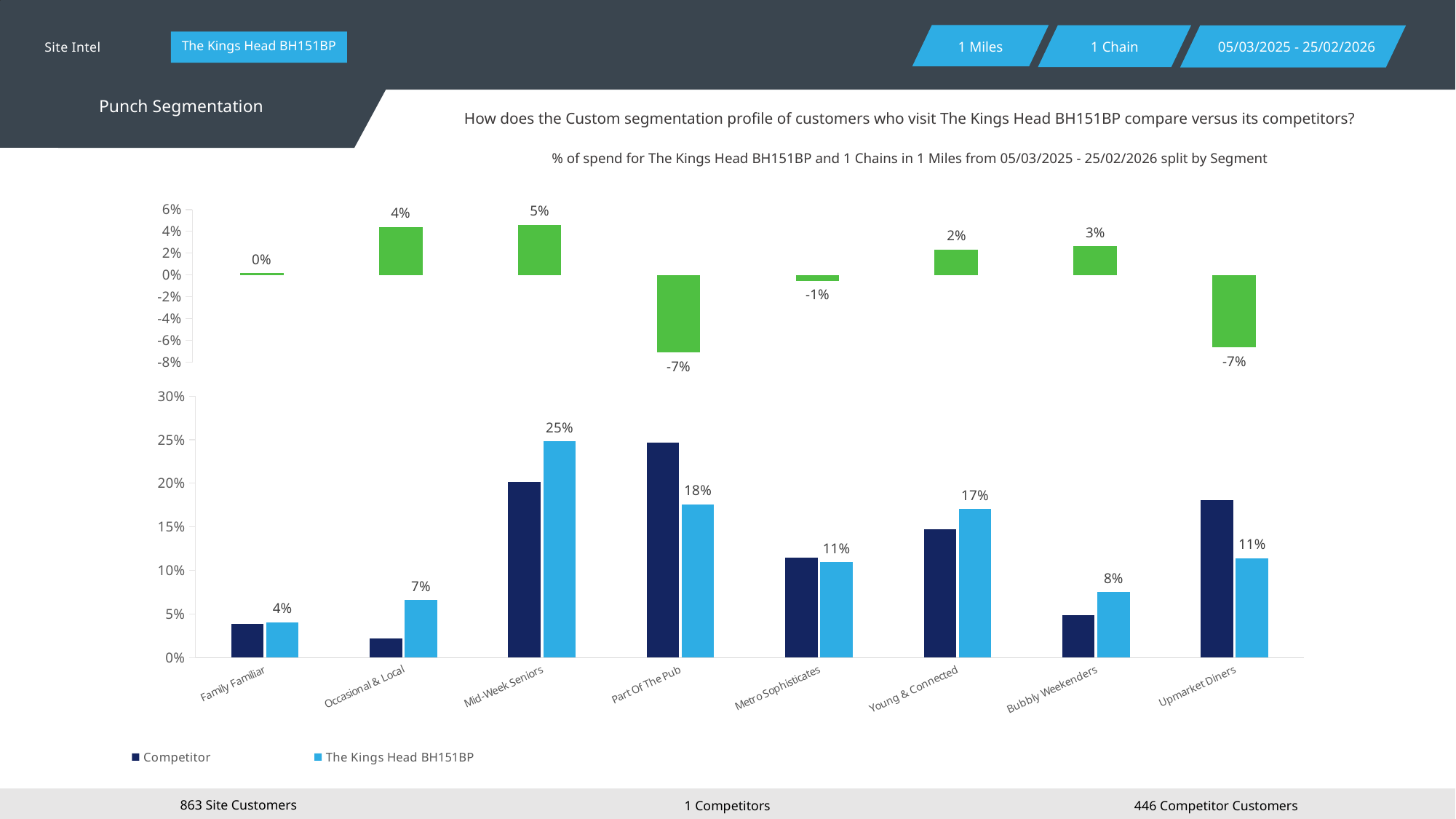
In the bottom chart, for Part Of The Pub, which is larger: the Competitor value or The Kings Head BH151BP value? Competitor In the bottom chart, which segment has the highest value for The Kings Head BH151BP? Mid-Week Seniors In the bottom chart, what is the value for The Kings Head BH151BP for Mid-Week Seniors? 25% How many series does the legend of the bottom chart list? 2 What kind of chart is the bottom chart? bar chart How many segments are shown on the x axis of the bottom chart? 8 In the bottom chart, is the Competitor value for Occasional & Local greater or less than 5%? less In the bottom chart, what is the value for The Kings Head BH151BP for Young & Connected? 17% In the bottom chart, which segment has the lowest value for The Kings Head BH151BP? Family Familiar In the bottom chart, is the Competitor value for Upmarket Diners greater or less than 15%? greater In the top chart, what is the value for Part Of The Pub? -7% In the bottom chart, what is the difference between The Kings Head BH151BP values for Mid-Week Seniors and Part Of The Pub? 7 percentage points